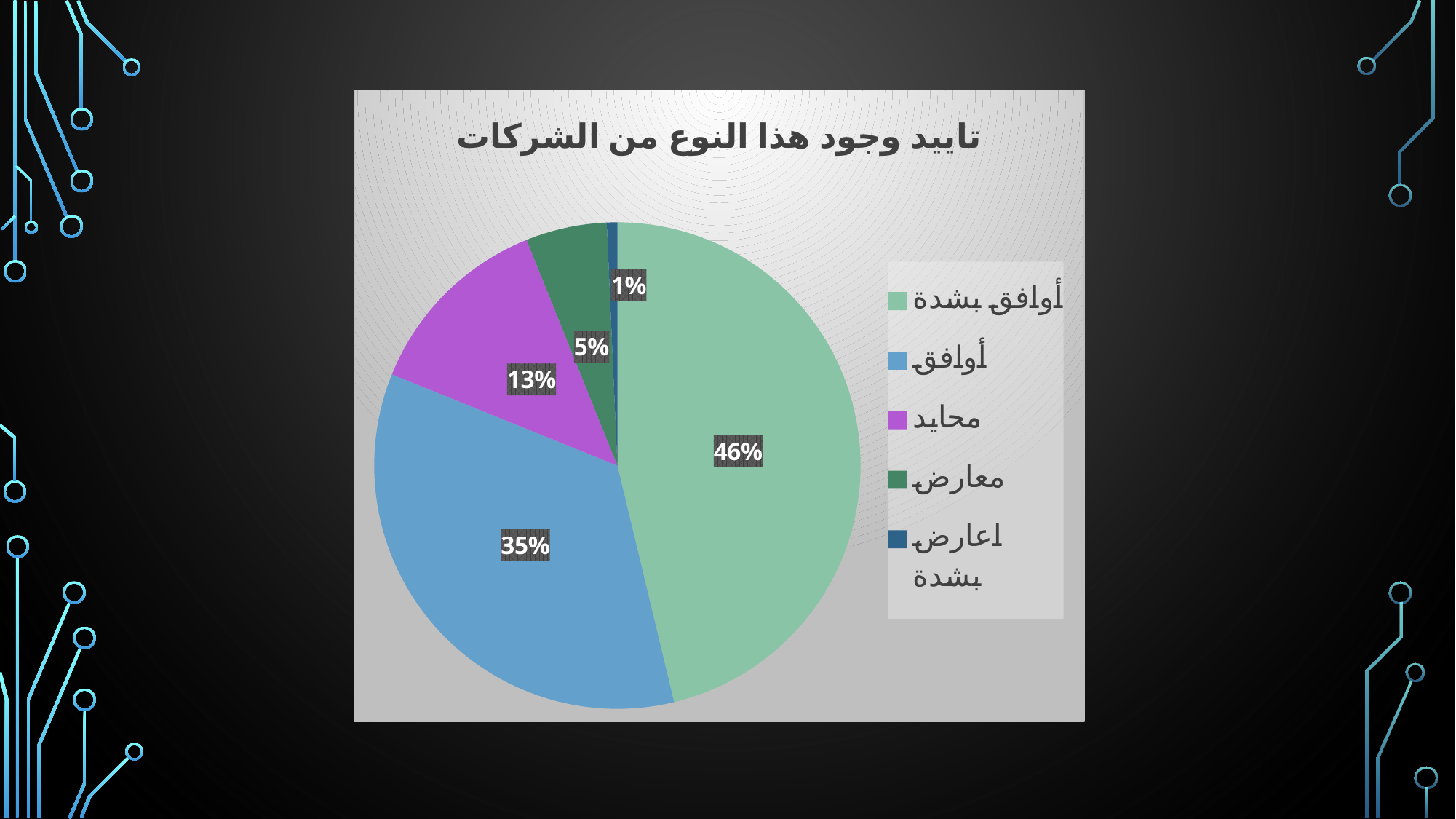
Which category has the smallest share of the pie? اعارض بشدة What percentage of the pie is labelled أوافق بشدة? 46% What percentage of the pie is labelled أوافق? 35% What kind of chart is shown on the slide? Pie chart What is the title of the chart? تاييد وجود هذا النوع من الشركات Which category has the largest share of the pie? أوافق بشدة What percentage of the pie is labelled محايد? 13% How many slices does the pie chart have? 5 What is the difference in percentage points between أوافق بشدة and أوافق? 11 What percentage of the pie is labelled معارض? 5% Which is larger, the share for محايد or the share for معارض? محايد